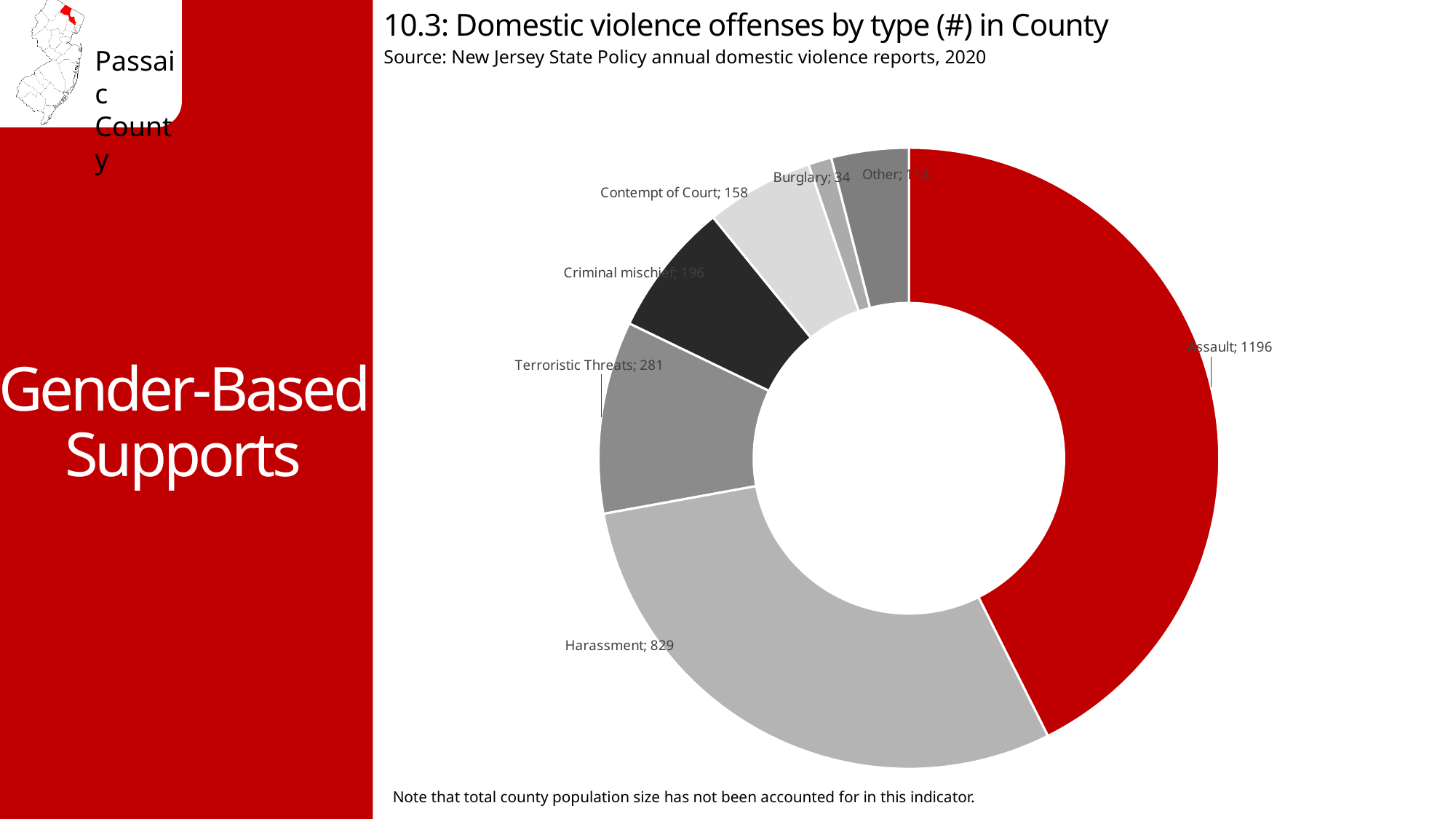
Which offense type has the largest slice? Assault What is the value for Contempt of Court? 158 Which is larger, Criminal mischief or Contempt of Court? Criminal mischief What is the value for Burglary? 34 How many domestic violence offenses are shown for Assault? 1196 What is the value for Criminal mischief? 196 What is the value for Harassment? 829 What is the difference between the Harassment and Terroristic Threats values? 548 What is the value for Terroristic Threats? 281 What kind of chart is shown on the slide? doughnut chart What is the title of the chart? 10.3: Domestic violence offenses by type (#) in County What is the difference between the Assault and Harassment values? 367